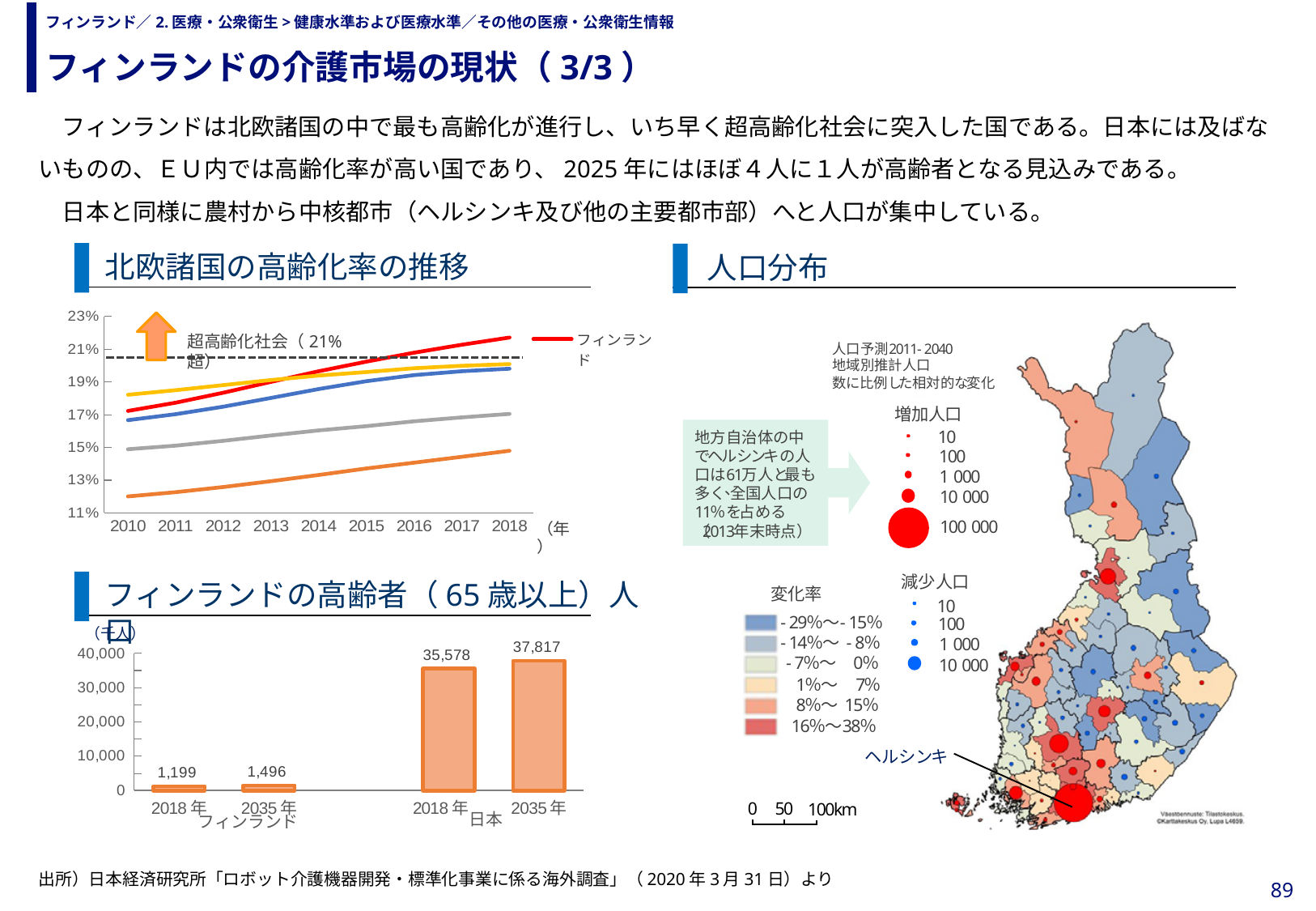
In the bar chart titled フィンランドの高齢者（65歳以上）人口, what is the value for 日本 in 2035年? 37,817 In the bar chart titled フィンランドの高齢者（65歳以上）人口, which bar has the highest value? 日本 2035年 In the line chart titled 北欧諸国の高齢化率の推移, is the value for フィンランド in 2018 greater or less than 21%? greater In the bar chart titled フィンランドの高齢者（65歳以上）人口, what is the value for フィンランド in 2018年? 1,199 In the line chart titled 北欧諸国の高齢化率の推移, how many years are shown on the x axis? 9 In the bar chart titled フィンランドの高齢者（65歳以上）人口, which bar has the lowest value? フィンランド 2018年 In the bar chart titled フィンランドの高齢者（65歳以上）人口, what is the value for フィンランド in 2035年? 1,496 In the bar chart titled フィンランドの高齢者（65歳以上）人口, what is the difference between the 日本 values for 2035年 and 2018年? 2,239 In the bar chart titled フィンランドの高齢者（65歳以上）人口, what is the difference between the フィンランド values for 2035年 and 2018年? 297 In the line chart titled 北欧諸国の高齢化率の推移, does the フィンランド line rise or fall from 2010 to 2018? rise What kind of chart is フィンランドの高齢者（65歳以上）人口? bar chart In the bar chart titled フィンランドの高齢者（65歳以上）人口, how many bars are plotted? 4